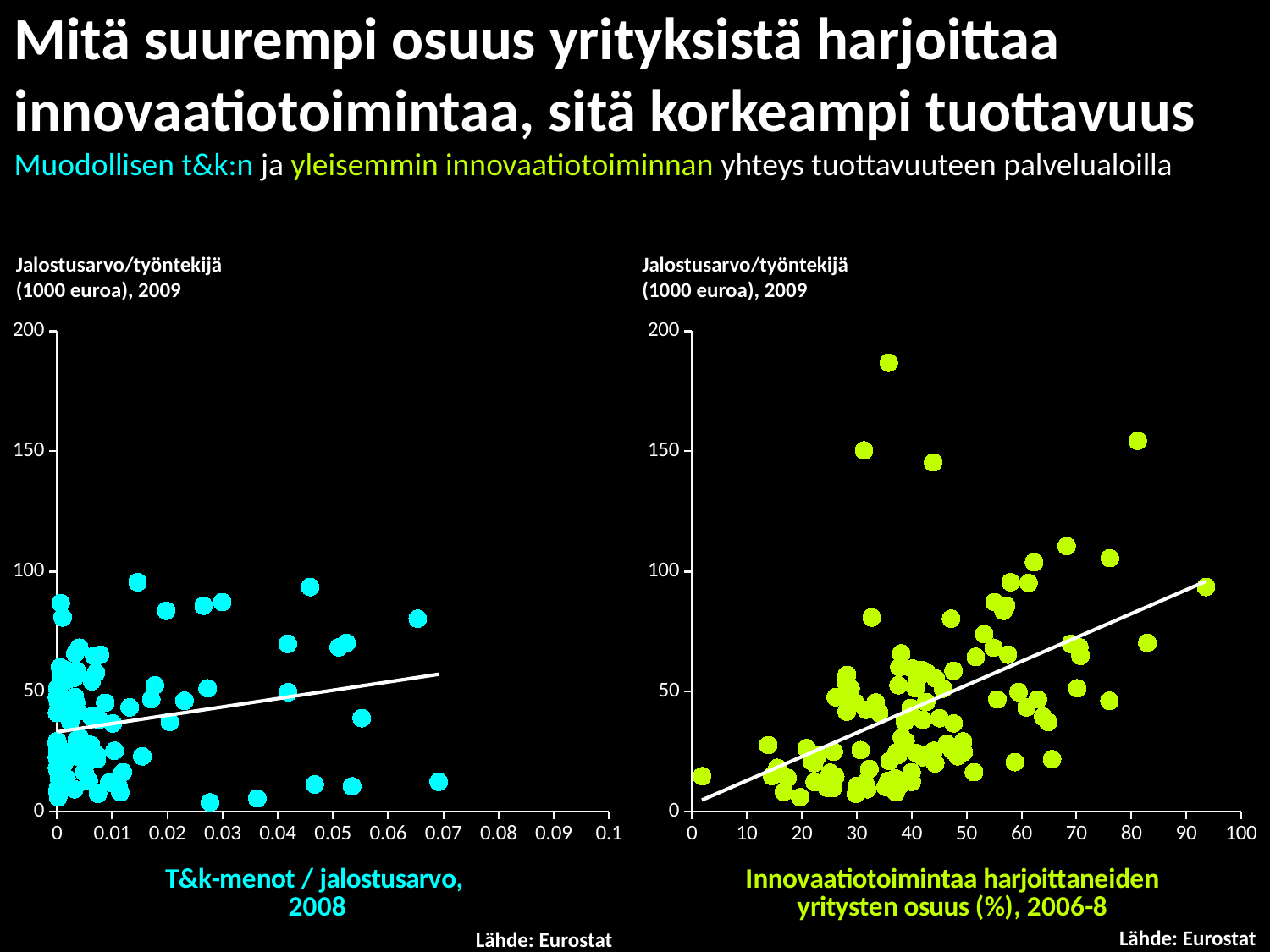
What kind of chart is the left chart (T&k-menot / jalostusarvo, 2008)? scatter chart What kind of chart is the right chart (Innovaatiotoimintaa harjoittaneiden yritysten osuus (%), 2006-8)? scatter chart In the left chart, does the white trend line rise or fall as T&k-menot / jalostusarvo increases? rises What is the y-axis label of the left chart? Jalostusarvo/työntekijä (1000 euroa), 2009 In the right chart, does the white trend line rise or fall as the share of innovating firms increases? rises In the right chart, is the highest plotted point greater or less than 150? greater In the right chart, is the rightmost plotted point (above 90 on the x axis) greater or less than 50 on the y axis? greater What source is cited for the charts? Eurostat Which chart has the steeper trend line, the left chart or the right chart? the right chart How many charts are shown on the slide? 2 In the left chart, is the highest plotted point greater or less than 100? less